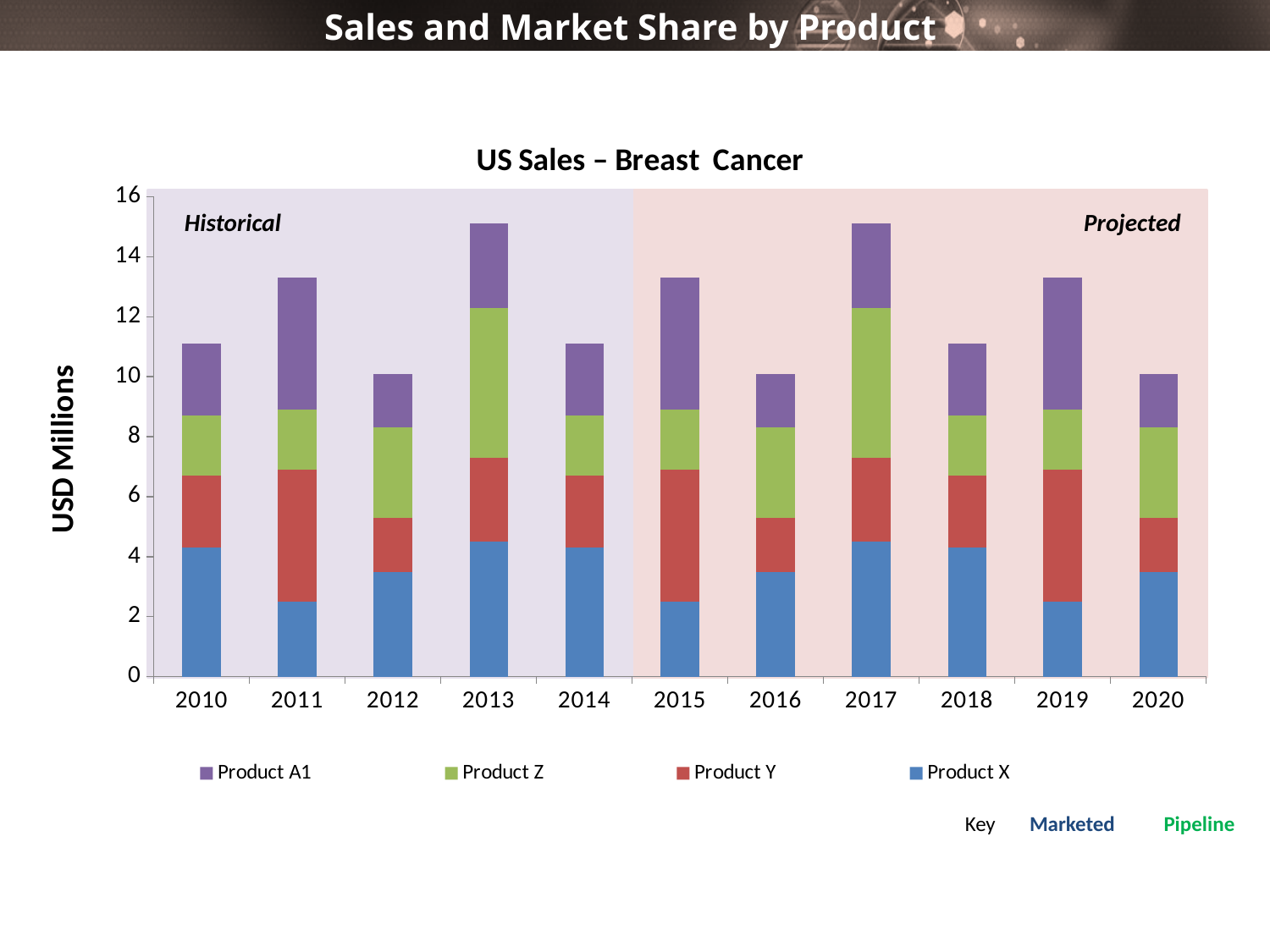
Which year has the larger Product A1 segment, 2010 or 2011? 2011 What is the label on the vertical axis of the chart? USD Millions Is the total bar height for 2011 greater or less than 12? greater What is the title of the chart? US Sales – Breast Cancer Is the total bar height for 2010 greater or less than 10? greater Is the total bar height for 2016 greater or less than 12? less How many series does the chart's legend list? 4 What kind of chart is shown on the slide? Stacked bar chart Which year has the taller total bar, 2012 or 2013? 2013 Which year has the larger Product X segment, 2010 or 2011? 2010 How many years are shown on the x axis of the chart? 11